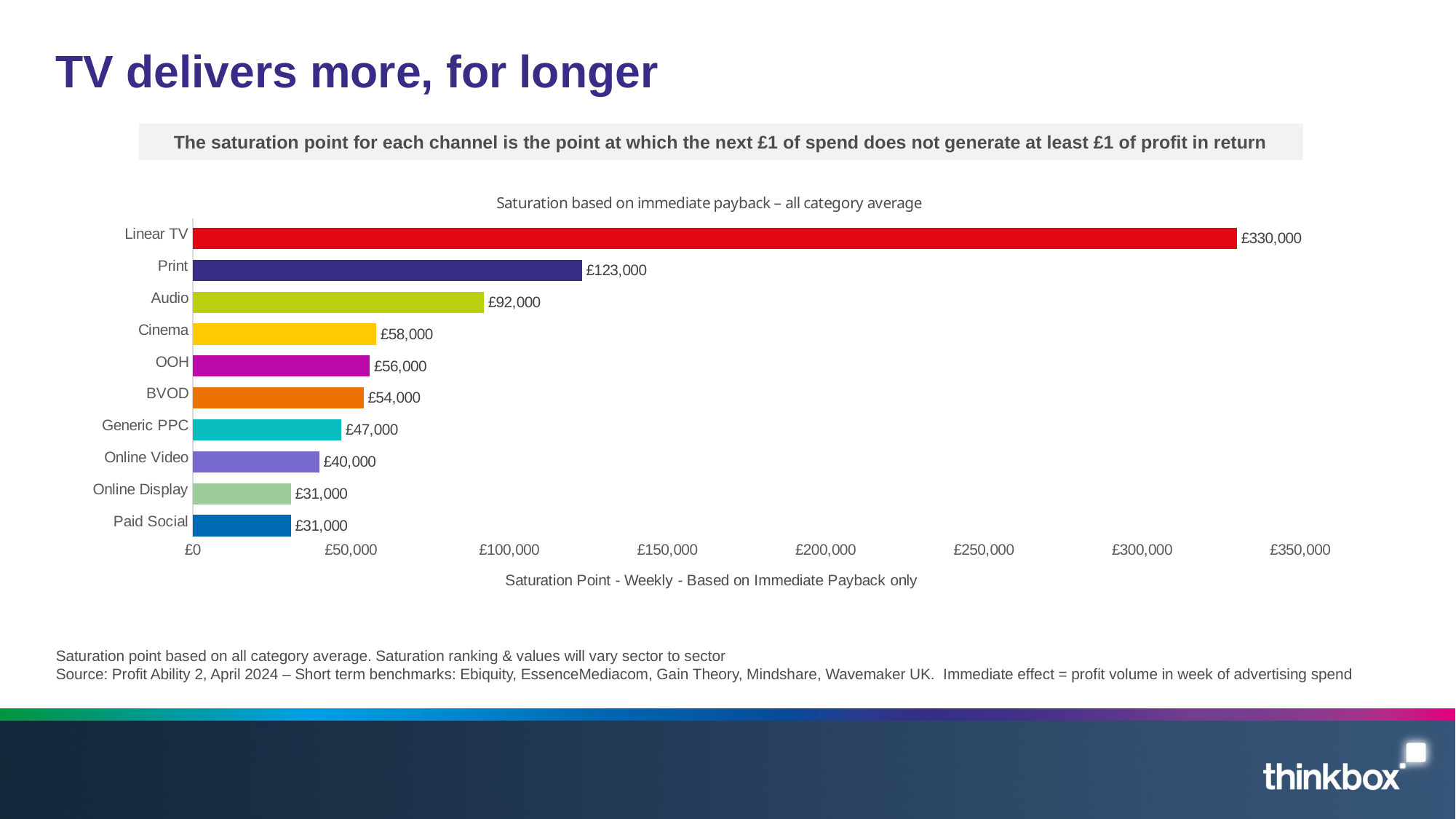
What is the title of the chart? Saturation based on immediate payback – all category average What is the saturation point for Generic PPC? £47,000 What is the saturation point for Linear TV? £330,000 What type of chart is shown on the slide? Bar chart What is the difference between the saturation points of Cinema and BVOD? £4,000 Which channel has the highest saturation point? Linear TV Which channels share the lowest saturation point? Online Display and Paid Social How many channels are shown in the chart? 10 What is the difference between the saturation points of Linear TV and Print? £207,000 What is the saturation point for Audio? £92,000 Is the saturation point for Online Video greater or less than £50,000? less Which has a higher saturation point, Print or Audio? Print